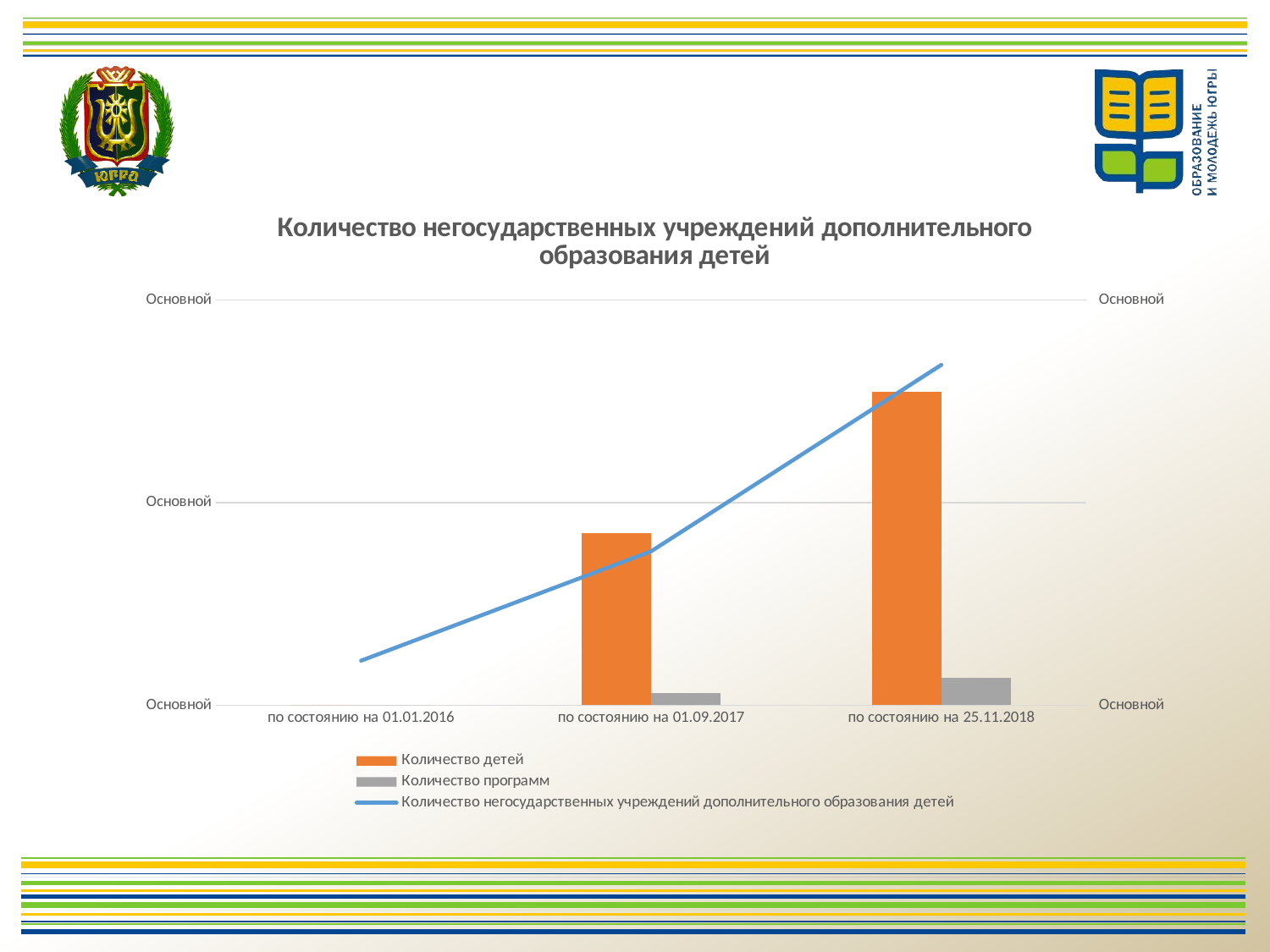
Is the value for Количество программ larger on 01.09.2017 or on 25.11.2018? 25.11.2018 Which category has the highest value for Количество детей? по состоянию на 25.11.2018 How many categories are shown on the x axis? 3 What kind of chart is shown on the slide? A combined bar and line chart How many series does the legend list? 3 At 25.11.2018, which is larger: Количество детей or Количество программ? Количество детей Which category has the highest value for Количество программ? по состоянию на 25.11.2018 Is the value for Количество детей larger on 01.09.2017 or on 25.11.2018? 25.11.2018 What is the title of the chart? Количество негосударственных учреждений дополнительного образования детей Which series is shown in orange? Количество детей Does the line for Количество негосударственных учреждений дополнительного образования детей rise or fall from 01.01.2016 to 25.11.2018? It rises